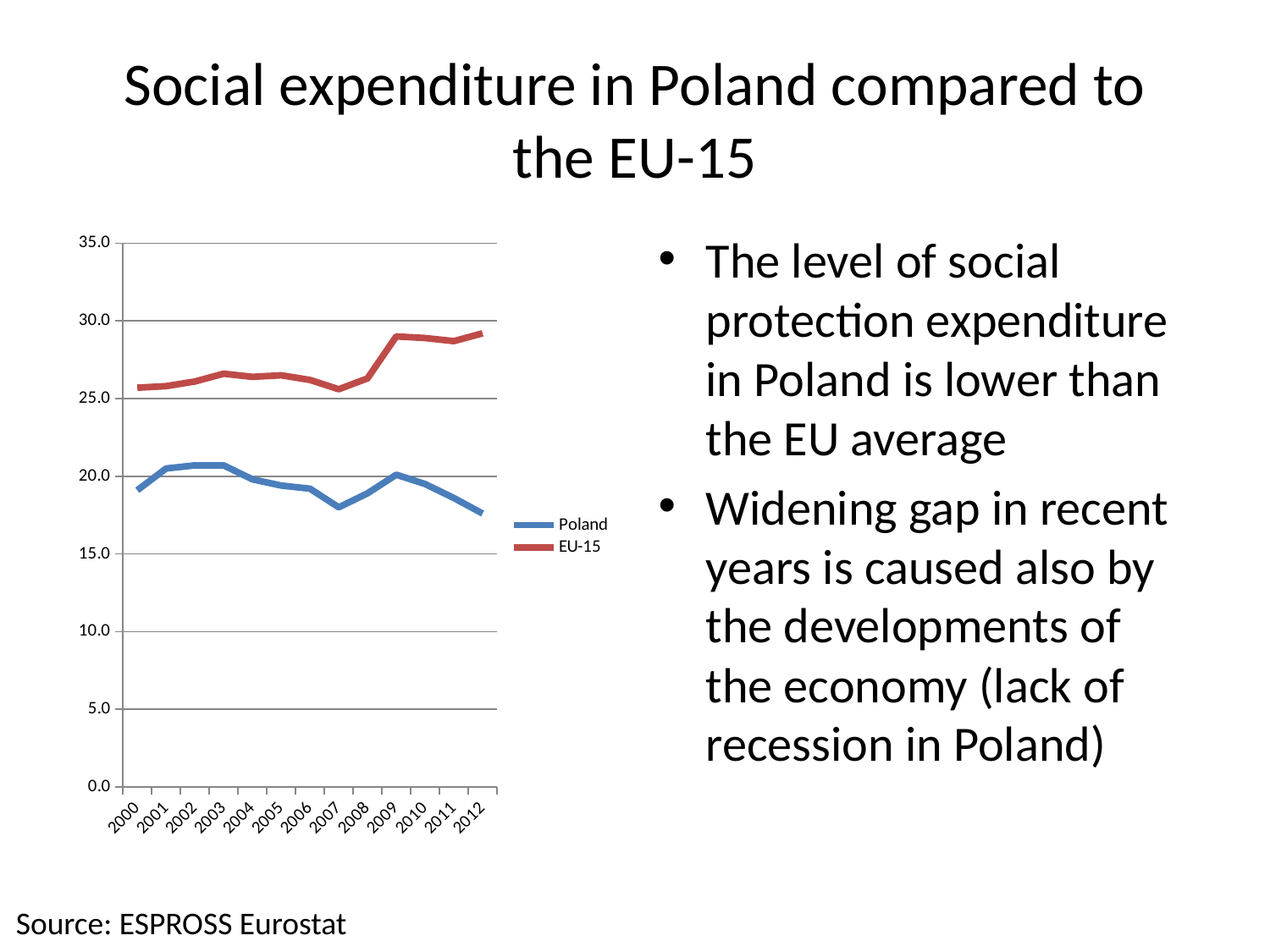
Is the value for Poland in 2012 greater or less than 20.0? less Which series has the lower value in 2000, Poland or EU-15? Poland How many series does the chart legend list? 2 Which series has the higher value in 2012, Poland or EU-15? EU-15 Is the value for Poland in 2007 greater or less than 20.0? less Is the value for EU-15 in 2009 greater or less than 25.0? greater Does the Poland line rise or fall between 2009 and 2012? fall Which colour is used for the Poland series in the chart? blue How many years are plotted along the x axis of the chart? 13 What kind of chart is shown on the slide? line chart Does the EU-15 line rise or fall between 2008 and 2009? rise